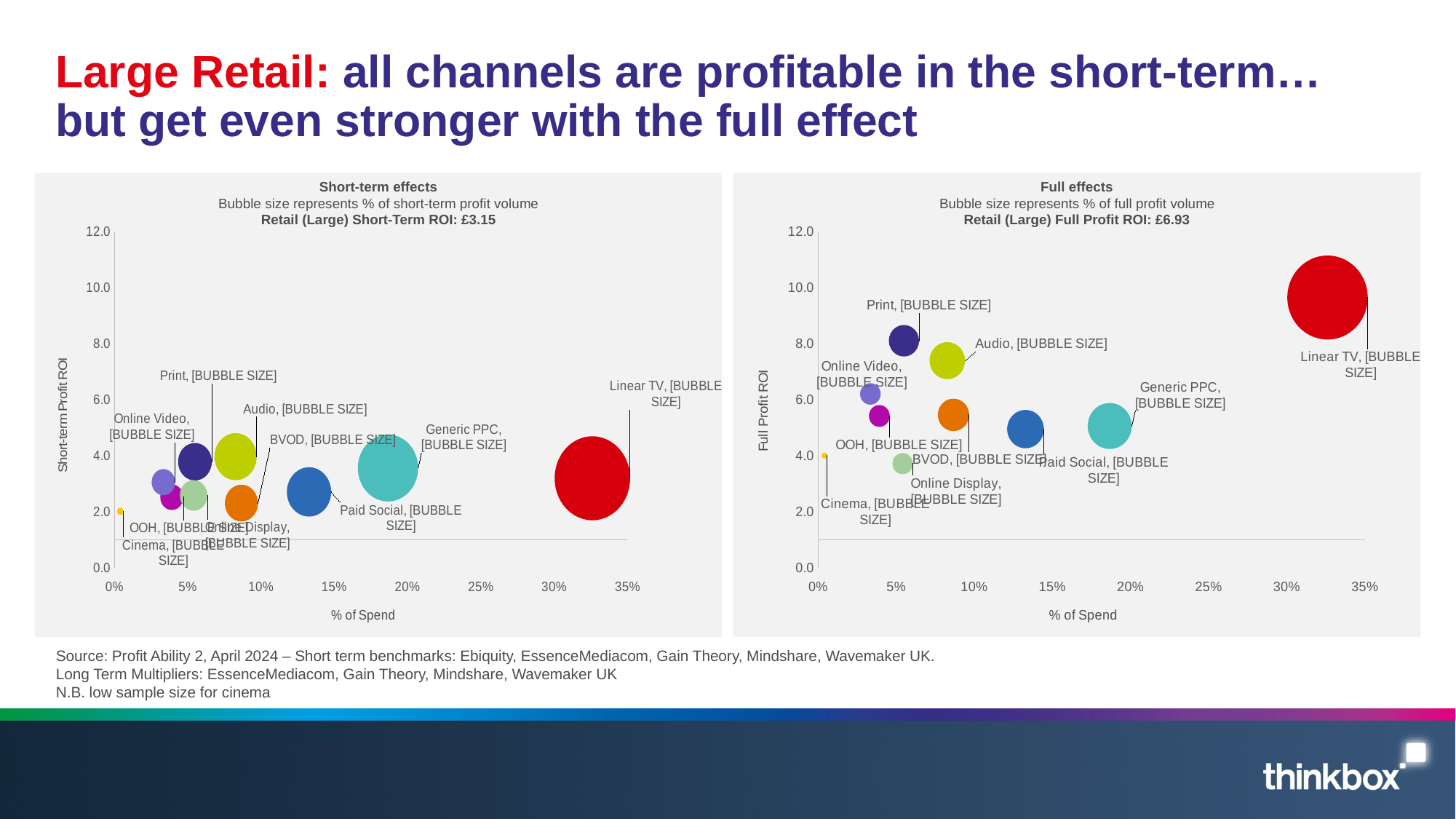
On the Full effects chart, what is the Retail (Large) Full Profit ROI stated in the chart title? £6.93 On the Full effects chart, which channel has the highest Full Profit ROI? Linear TV On the Short-term effects chart, which channel has the lowest % of Spend? Cinema On the Short-term effects chart, what is the Retail (Large) Short-Term ROI stated in the chart title? £3.15 How many channels are plotted on the Short-term effects chart? 10 On the Full effects chart, is the Full Profit ROI for Linear TV greater or less than 8.0? greater On the Full effects chart, is the Full Profit ROI for Print greater or less than 6.0? greater On the Short-term effects chart, which channel has the highest % of Spend? Linear TV What kind of chart is the Short-term effects chart? Bubble chart What is the x-axis label on the Full effects chart? % of Spend What is the difference between the Retail (Large) Full Profit ROI (£6.93) and the Short-Term ROI (£3.15) shown in the chart titles? £3.78 On the Short-term effects chart, is the Short-term Profit ROI for Linear TV greater or less than 4.0? less